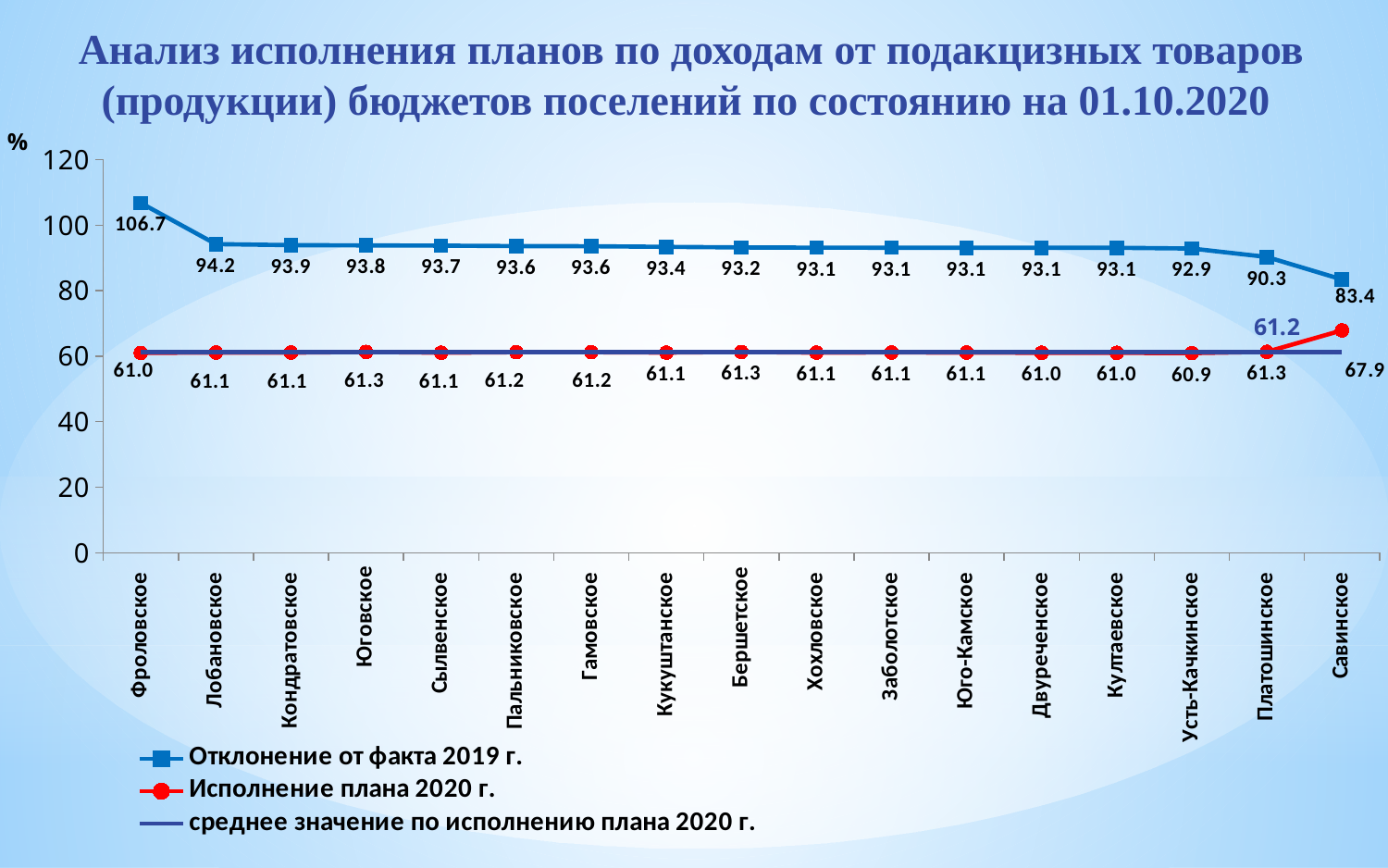
How many settlements (categories) are plotted along the x axis? 17 Which settlement has the highest value for 'Отклонение от факта 2019 г.'? Фроловское Which settlement has the highest value for 'Исполнение плана 2020 г.'? Савинское What type of chart is shown on the slide? line chart What is the value of 'Отклонение от факта 2019 г.' for Фроловское? 106.7 Which settlement has the lowest value for 'Отклонение от факта 2019 г.'? Савинское What value is shown for the line 'среднее значение по исполнению плана 2020 г.'? 61.2 What is the value of 'Исполнение плана 2020 г.' for Савинское? 67.9 What is the difference between the 'Отклонение от факта 2019 г.' values for Фроловское and Лобановское? 12.5 What is the value of 'Отклонение от факта 2019 г.' for Платошинское? 90.3 How many series does the legend list? 3 Which is larger for Савинское: 'Отклонение от факта 2019 г.' or 'Исполнение плана 2020 г.'? Отклонение от факта 2019 г.